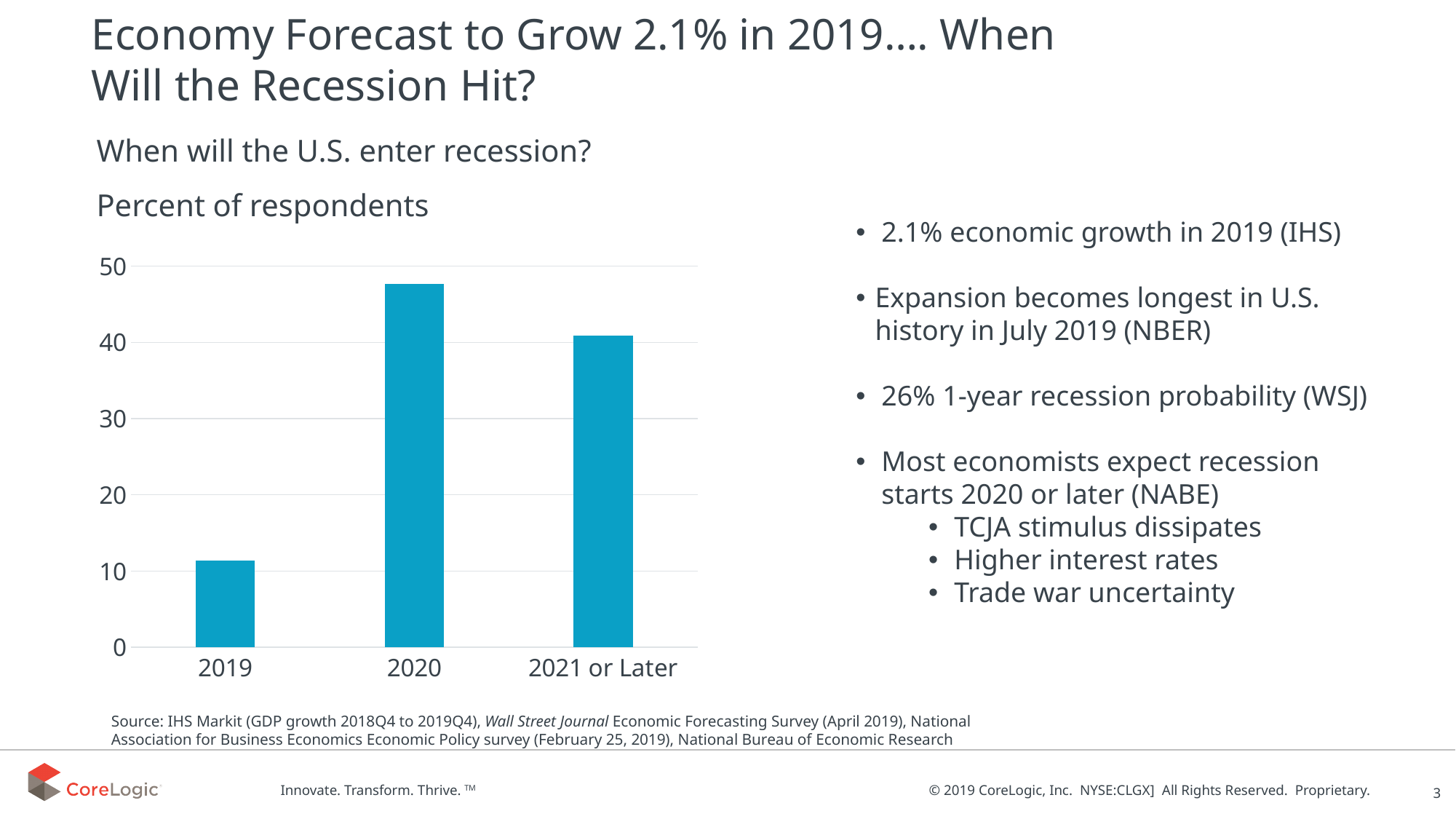
Is the value for 2019 greater or less than 20? less Which category has the lowest percent of respondents? 2019 What kind of chart is shown on the slide? bar chart Is the value for 2020 greater or less than 40? greater Is the value for 2021 or Later greater or less than 30? greater What does the chart's y axis measure, according to the label above it? Percent of respondents Which category has the highest percent of respondents? 2020 How many categories are shown on the x axis of the chart? 3 What question does the chart answer, according to the heading above it? When will the U.S. enter recession? Which is larger, the value for 2019 or the value for 2021 or Later? 2021 or Later Which is larger, the value for 2020 or the value for 2021 or Later? 2020